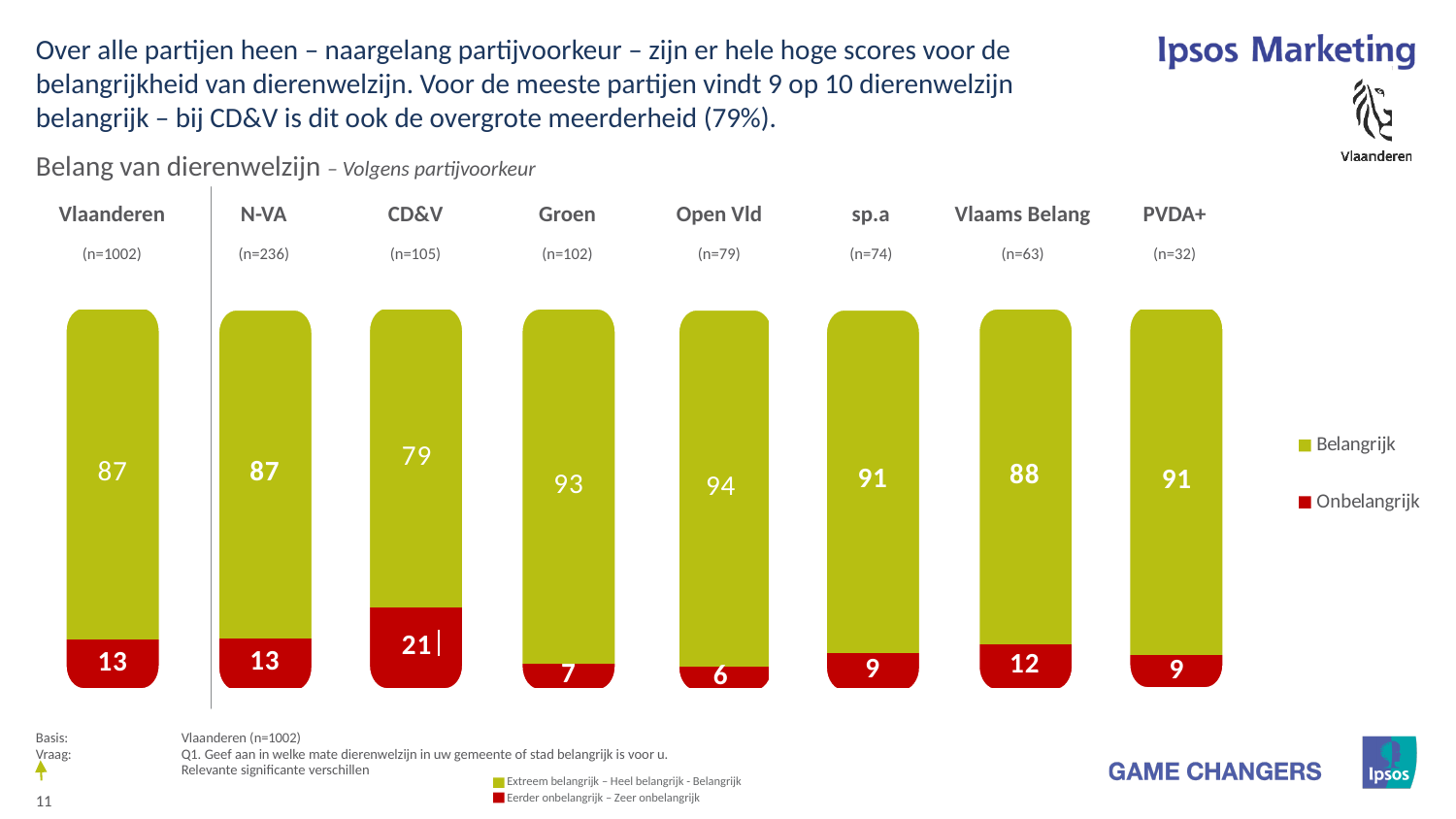
What is the Belangrijk value for Open Vld? 94 What is the difference between the Belangrijk values for Groen and CD&V? 14 How many series does the legend list? 2 What is the total of the stacked bar for PVDA+? 100 Which party has the lowest Belangrijk value? CD&V Which category has the highest Onbelangrijk value? CD&V What kind of chart is shown on the slide? Stacked bar chart What is the Onbelangrijk value for Vlaams Belang? 12 How many categories are shown on the x axis? 8 What is the Belangrijk value for CD&V? 79 Which party has the highest Belangrijk value? Open Vld Which is larger, the Onbelangrijk value for N-VA or for sp.a? N-VA